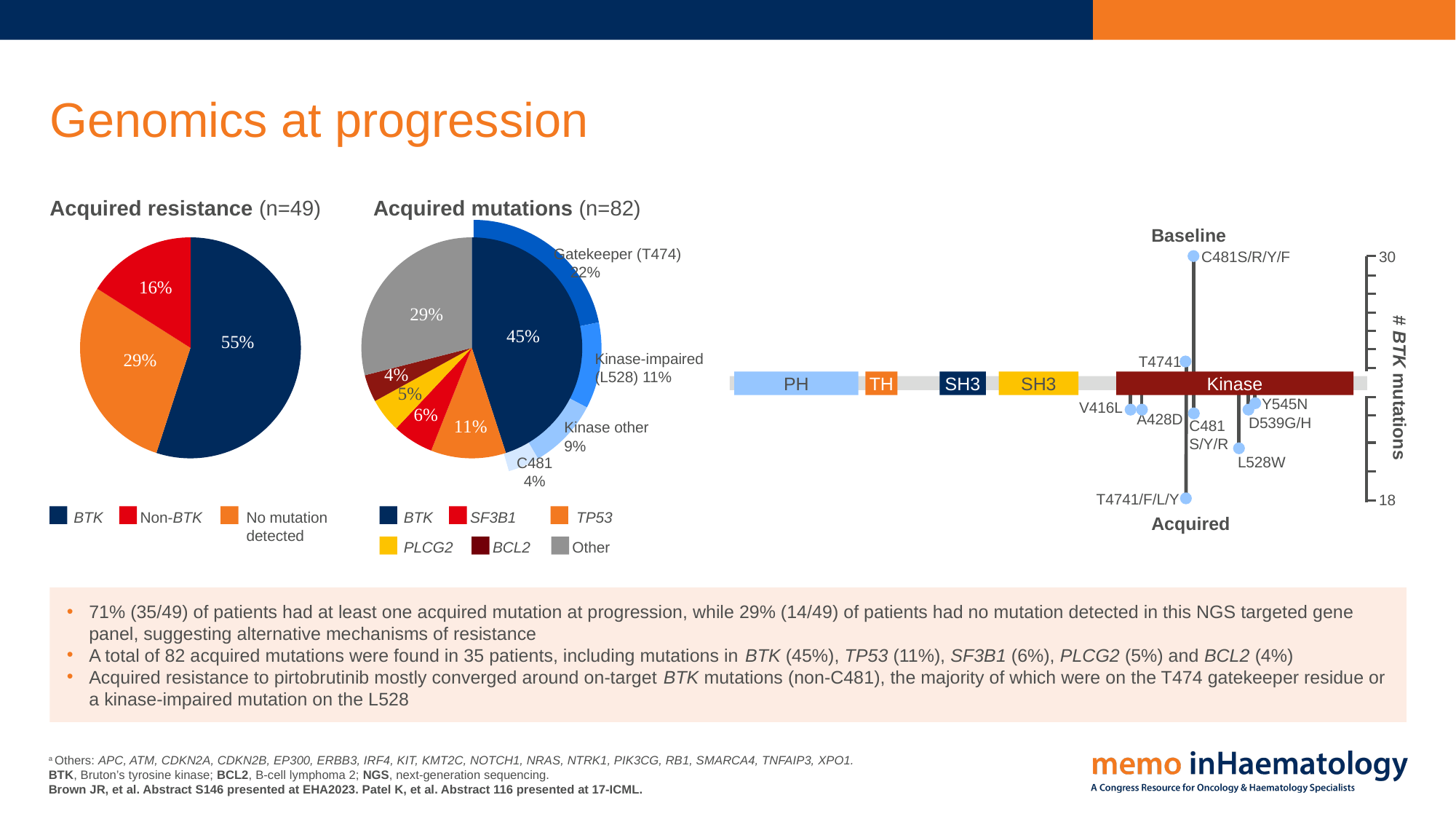
How many categories does the legend of the 'Acquired mutations (n=82)' pie chart list? 6 In the 'Acquired mutations (n=82)' pie chart, what share of mutations were in TP53? 11% In the 'Acquired resistance (n=49)' pie chart, which category has the smallest slice? Non-BTK In the 'Acquired mutations (n=82)' pie chart, what percentage is labelled for Gatekeeper (T474) mutations? 22% In the 'Acquired resistance (n=49)' pie chart, what share of patients had a BTK mutation? 55% How many categories does the legend of the 'Acquired resistance (n=49)' pie chart list? 3 In the 'Acquired mutations (n=82)' pie chart, what share of mutations were in PLCG2? 5% In the 'Acquired resistance (n=49)' pie chart, what share of patients had no mutation detected? 29% What type of chart is used for 'Acquired resistance (n=49)'? Pie chart In the 'Acquired mutations (n=82)' pie chart, which gene category has the largest slice? BTK In the 'Acquired mutations (n=82)' pie chart, which is larger: the SF3B1 slice or the BCL2 slice? SF3B1 In the 'Acquired resistance (n=49)' pie chart, what is the difference in percentage points between the BTK slice and the Non-BTK slice? 39 percentage points